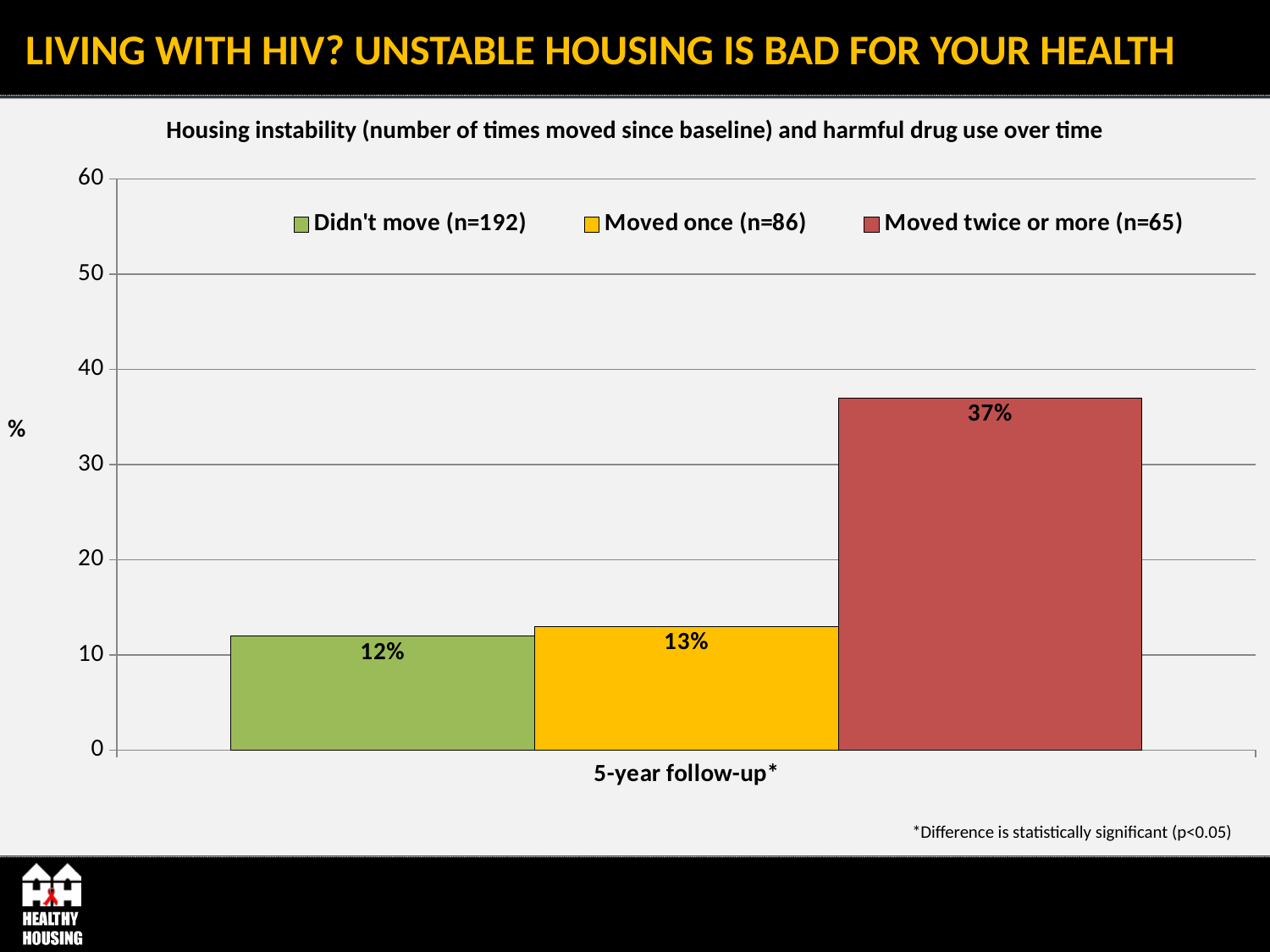
What kind of chart is shown on the slide? Bar chart What is the value for the 'Moved twice or more (n=65)' series at 5-year follow-up? 37% What is the difference between the 'Moved once (n=86)' value and the 'Didn't move (n=192)' value? 1% Which is larger: the value for 'Moved twice or more (n=65)' or the value for 'Moved once (n=86)'? Moved twice or more (n=65) What is the difference between the 'Moved twice or more (n=65)' value and the 'Didn't move (n=192)' value? 25% Which series has the highest value at 5-year follow-up? Moved twice or more (n=65) How many series does the legend list? 3 Is the value for 'Moved twice or more (n=65)' greater or less than 30? greater Which series has the lowest value at 5-year follow-up? Didn't move (n=192) What is the title of the chart? Housing instability (number of times moved since baseline) and harmful drug use over time What is the value for the 'Didn't move (n=192)' series at 5-year follow-up? 12% What is the value for the 'Moved once (n=86)' series at 5-year follow-up? 13%